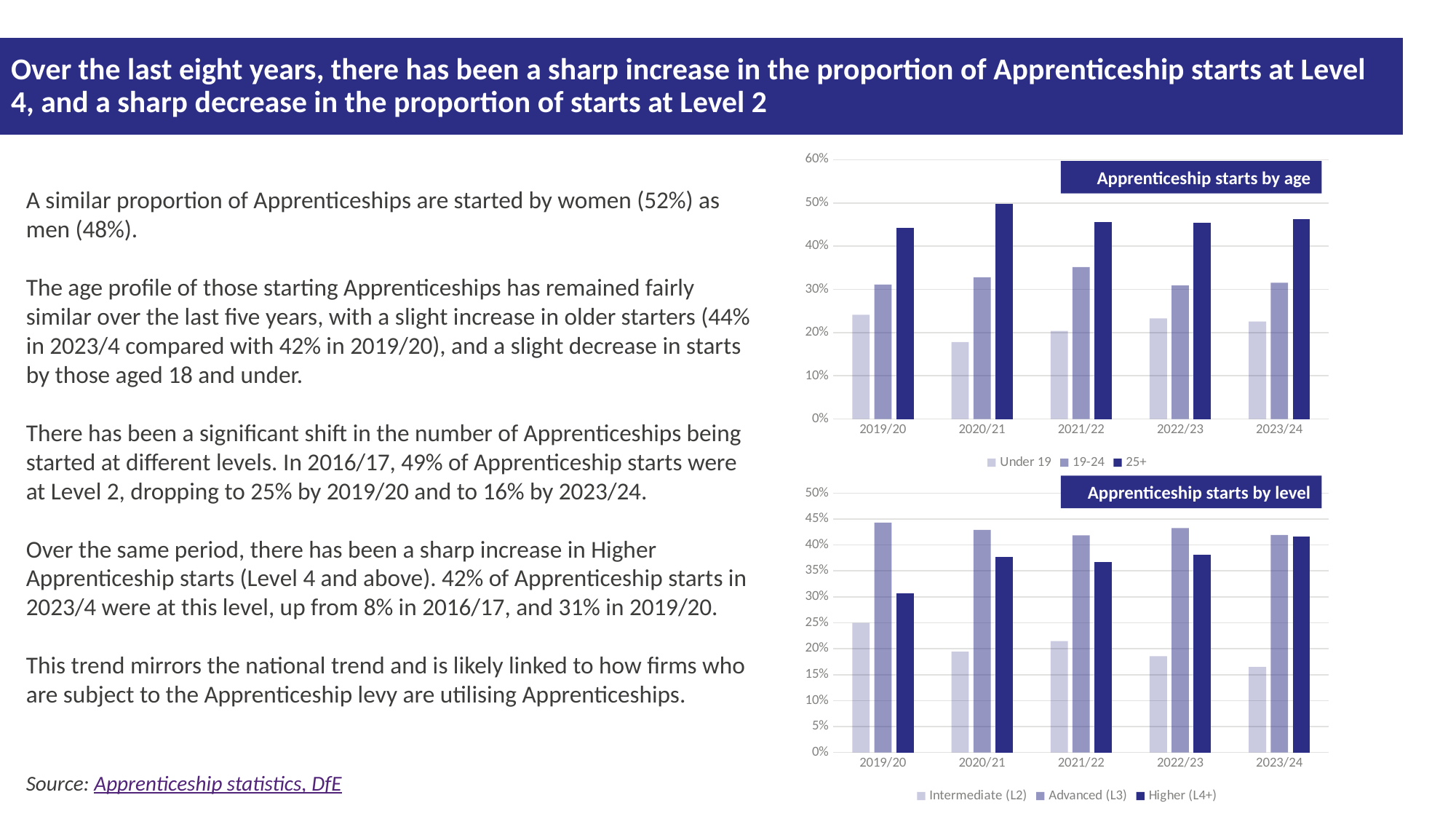
In the 'Apprenticeship starts by level' chart, is the value for Intermediate (L2) in 2023/24 greater or less than 20%? less In the 'Apprenticeship starts by age' chart, which age group has the highest value in 2020/21? 25+ How many series does the legend of the 'Apprenticeship starts by age' chart list? 3 In the 'Apprenticeship starts by age' chart, is the value for Under 19 in 2020/21 greater or less than 20%? less In the 'Apprenticeship starts by level' chart, do the values for Intermediate (L2) rise or fall from 2019/20 to 2023/24? fall What type of chart is the 'Apprenticeship starts by age' chart? bar chart In the 'Apprenticeship starts by level' chart, which is larger in 2019/20: Intermediate (L2) or Higher (L4+)? Higher (L4+) In the 'Apprenticeship starts by age' chart, is the value for 25+ in 2019/20 greater or less than 40%? greater How many years are shown on the x axis of the 'Apprenticeship starts by level' chart? 5 In the 'Apprenticeship starts by level' chart, which level has the highest value in 2019/20? Advanced (L3) What are the legend entries of the 'Apprenticeship starts by level' chart? Intermediate (L2), Advanced (L3), Higher (L4+) In the 'Apprenticeship starts by age' chart, which age group has the lowest value in 2023/24? Under 19